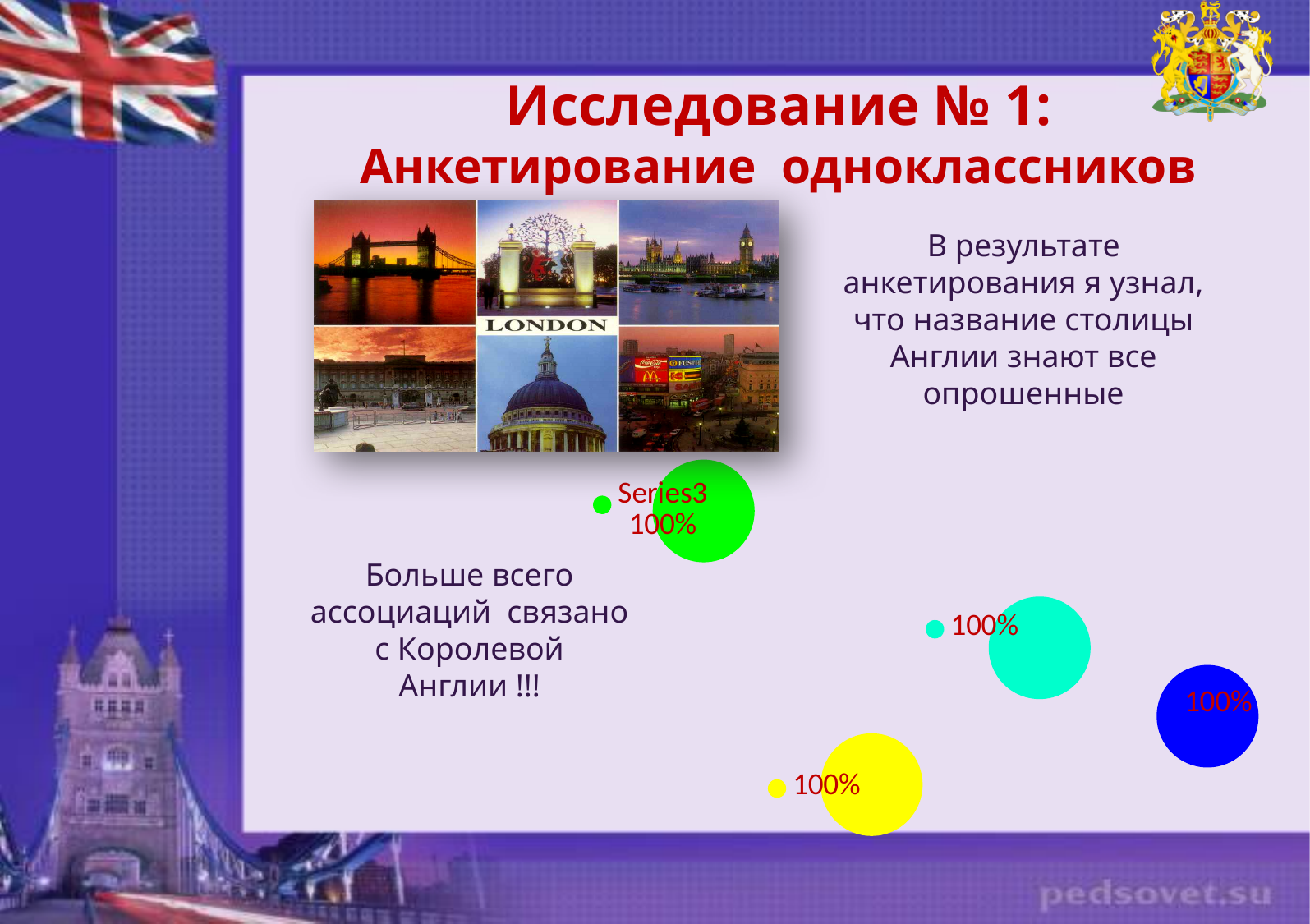
Do the values of the bubbles differ from one another, or are they all the same? all the same How many bubbles are plotted on the chart? 4 Which series name is printed on the chart? Series3 What kind of chart is shown on the slide? bubble chart What is the difference between the value of the green bubble and the value of the blue bubble? 0% What value is shown on the cyan bubble? 100% What colour is the bubble labelled Series3? green What value is shown on the blue bubble? 100% What value is shown for Series3 on the chart? 100% What value is shown on the yellow bubble? 100% Is the value for Series3 greater or less than 50%? greater